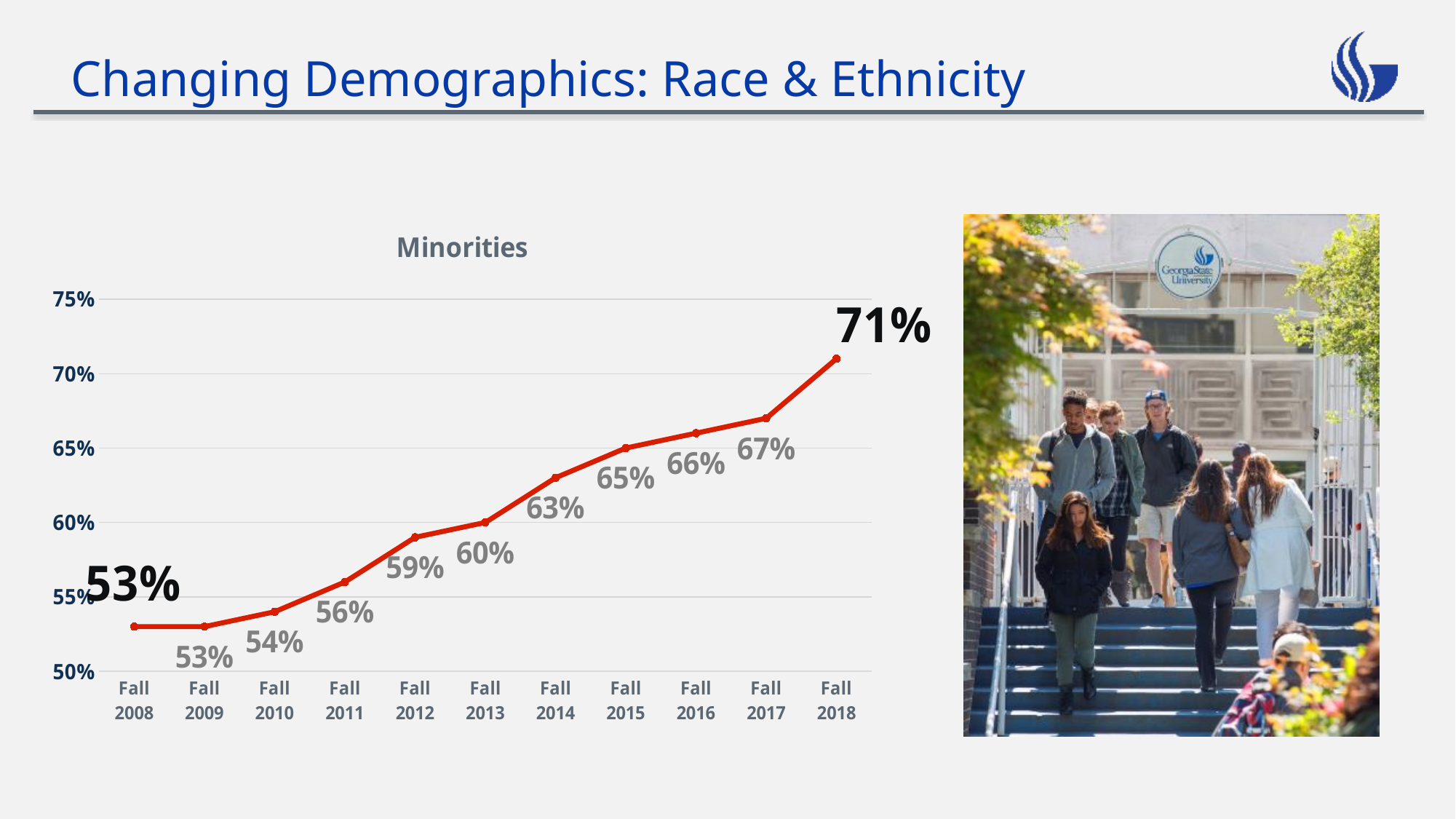
Is the value for Fall 2017 greater or less than 65%? greater What is the value for Fall 2016? 66% What is the value for Fall 2013? 60% What is the difference between the Fall 2014 and Fall 2011 values? 7% What is the value for Fall 2008? 53% What kind of chart is shown? line chart What is the value for Fall 2018? 71% Which year has the highest value? Fall 2018 What is the difference between the Fall 2018 and Fall 2008 values? 18% How many data points are plotted on the chart? 11 Do the values rise or fall from Fall 2008 to Fall 2018? rise Which is larger, the value for Fall 2012 or the value for Fall 2015? Fall 2015